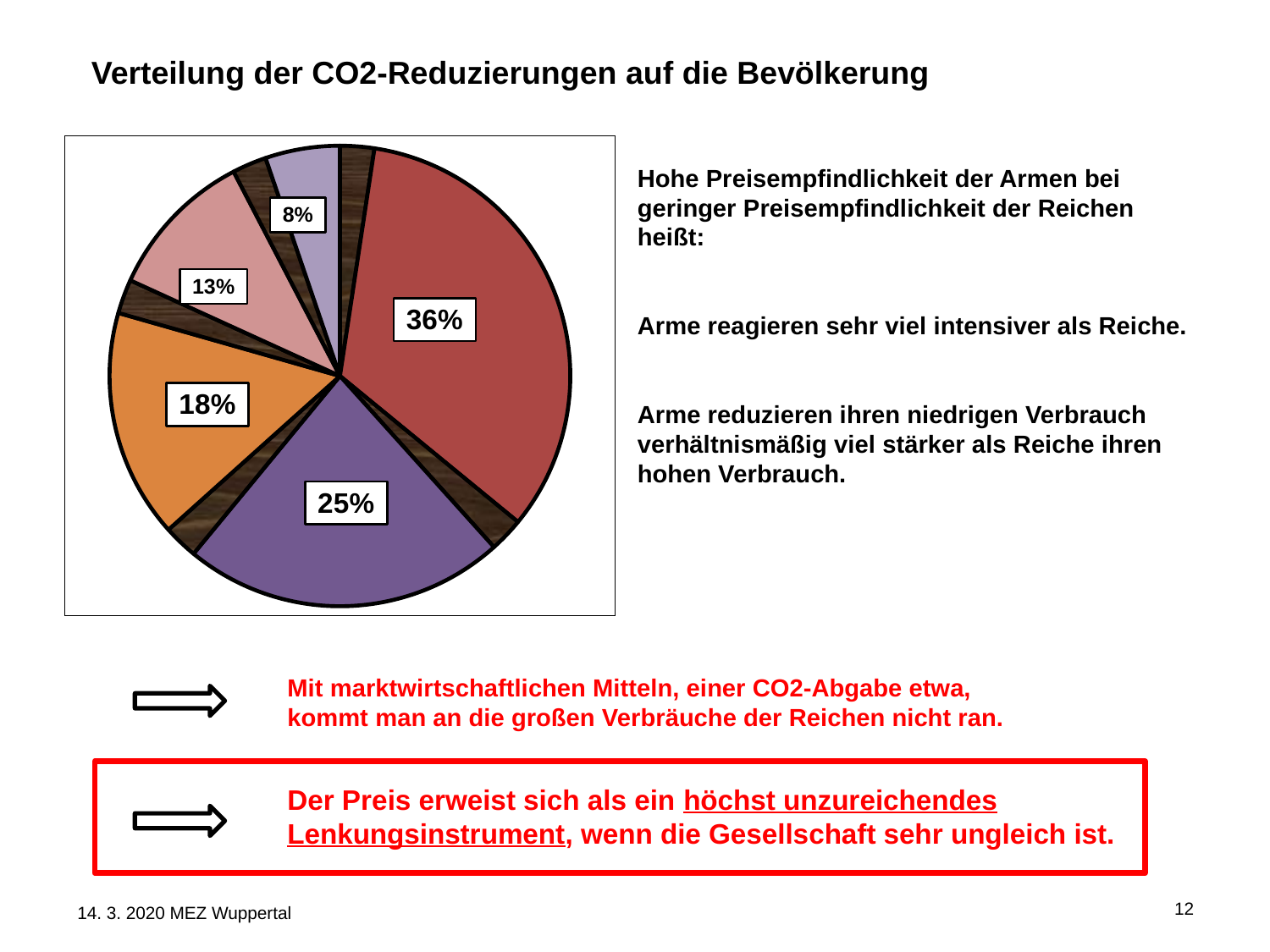
What percentage is shown on the orange slice of the pie chart? 18% How many slices of the pie chart carry a percentage label? 5 What percentage is shown on the purple slice of the pie chart? 25% Which labeled slice of the pie chart is the largest? the red slice (36%) What is the difference in percentage points between the red slice and the purple slice? 11 Which slice is larger, the orange slice or the pink slice? the orange slice What is the title of the chart on the slide? Verteilung der CO2-Reduzierungen auf die Bevölkerung What percentage is shown on the pink slice of the pie chart? 13% Which labeled slice of the pie chart is the smallest? the light purple slice (8%) What kind of chart is shown on the slide? pie chart What percentage is shown on the light purple slice of the pie chart? 8% What percentage is shown on the red slice of the pie chart? 36%